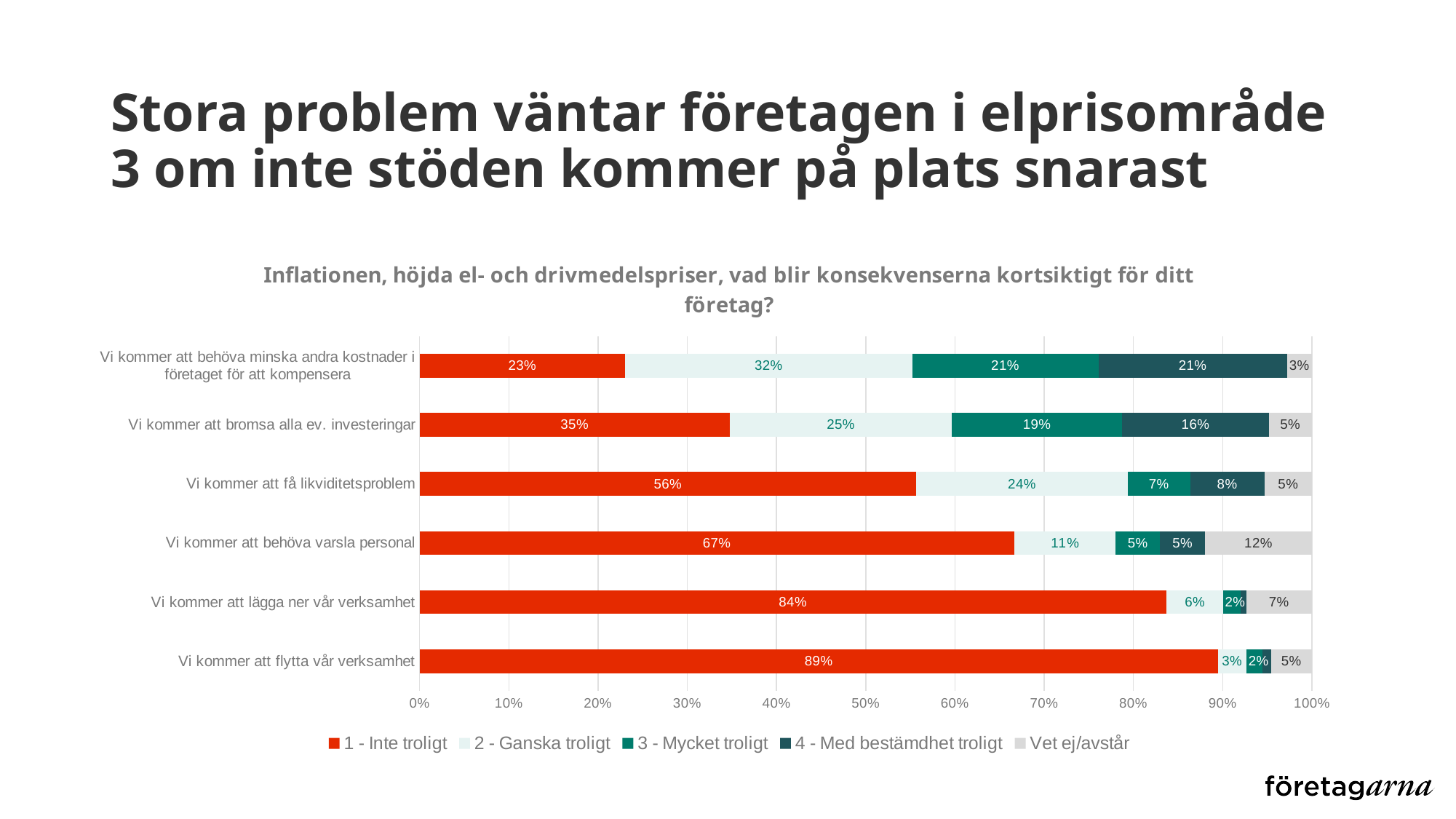
What is the total of all segments in the bar for 'Vi kommer att behöva minska andra kostnader i företaget för att kompensera'? 100% What kind of chart is shown on the slide? Stacked bar chart How many series does the legend list? 5 What is the value of '1 - Inte troligt' for 'Vi kommer att få likviditetsproblem'? 56% How many categories (statements) are plotted on the chart? 6 What is the difference in '1 - Inte troligt' between 'Vi kommer att flytta vår verksamhet' and 'Vi kommer att lägga ner vår verksamhet'? 5 percentage points Which statement has the lowest value for '1 - Inte troligt'? Vi kommer att behöva minska andra kostnader i företaget för att kompensera What is the value of 'Vet ej/avstår' for 'Vi kommer att behöva varsla personal'? 12% Which statement has the highest value for '1 - Inte troligt'? Vi kommer att flytta vår verksamhet What is the value of '2 - Ganska troligt' for 'Vi kommer att behöva minska andra kostnader i företaget för att kompensera'? 32% Which has a larger '3 - Mycket troligt' value: 'Vi kommer att bromsa alla ev. investeringar' or 'Vi kommer att få likviditetsproblem'? Vi kommer att bromsa alla ev. investeringar What is the first entry listed in the chart legend? 1 - Inte troligt